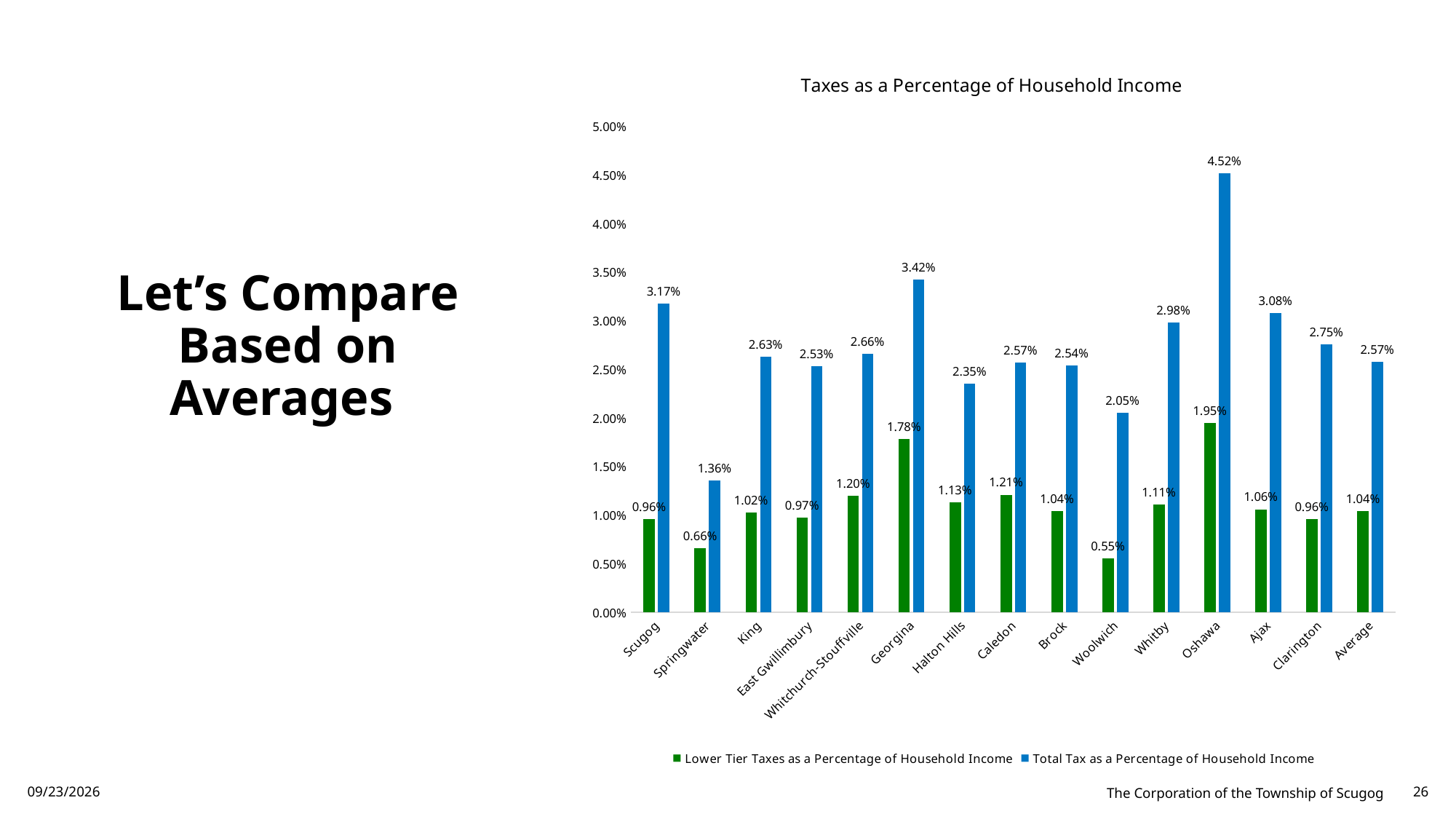
What is the title of the chart? Taxes as a Percentage of Household Income What is the Total Tax as a Percentage of Household Income for Oshawa? 4.52% How many series does the legend list? 2 How many categories are shown on the x axis of the chart? 15 Is the Total Tax as a Percentage of Household Income for Springwater greater or less than 1.50%? less What is the Lower Tier Taxes as a Percentage of Household Income for Scugog? 0.96% What is the Total Tax as a Percentage of Household Income for Georgina? 3.42% What is the difference between the Total Tax and Lower Tier Taxes percentages for Scugog? 2.21% Which municipality has the highest Total Tax as a Percentage of Household Income? Oshawa Which has a higher Total Tax as a Percentage of Household Income, Whitby or Ajax? Ajax What kind of chart is shown on the slide? Bar chart Which municipality has the lowest Lower Tier Taxes as a Percentage of Household Income? Woolwich